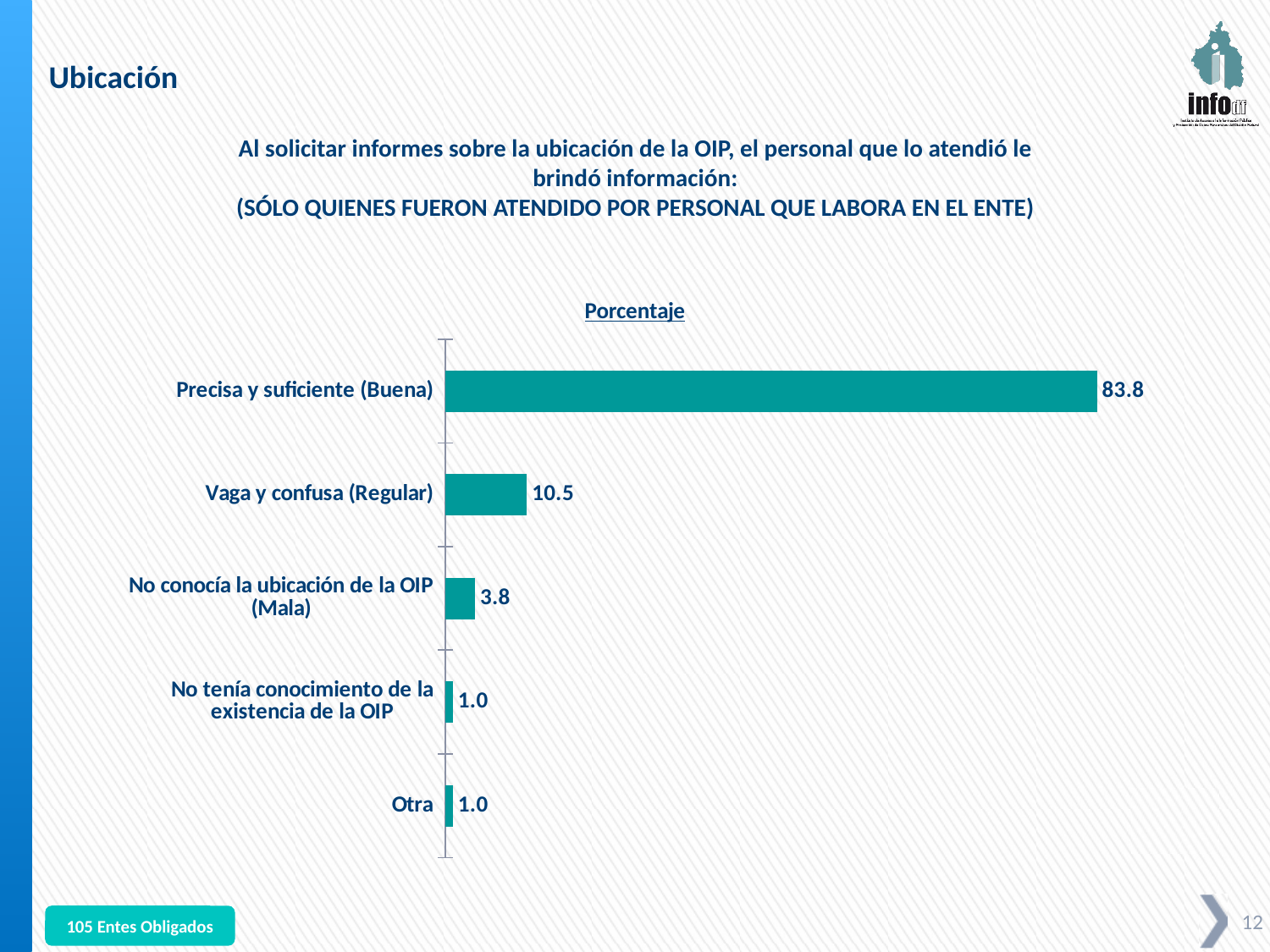
What is the value for "Precisa y suficiente (Buena)"? 83.8 What is the value for "Otra"? 1.0 How many categories are shown in the chart? 5 What is the difference between the values for "Precisa y suficiente (Buena)" and "Vaga y confusa (Regular)"? 73.3 Which two categories share the same value of 1.0? No tenía conocimiento de la existencia de la OIP and Otra What kind of chart is shown on the slide? Bar chart What is the value for "Vaga y confusa (Regular)"? 10.5 What is the difference between the values for "Vaga y confusa (Regular)" and "No conocía la ubicación de la OIP (Mala)"? 6.7 Which category has the highest value? Precisa y suficiente (Buena) Which is larger, the value for "Vaga y confusa (Regular)" or the value for "No conocía la ubicación de la OIP (Mala)"? Vaga y confusa (Regular) What is the value for "No conocía la ubicación de la OIP (Mala)"? 3.8 What is the title shown above the chart? Porcentaje